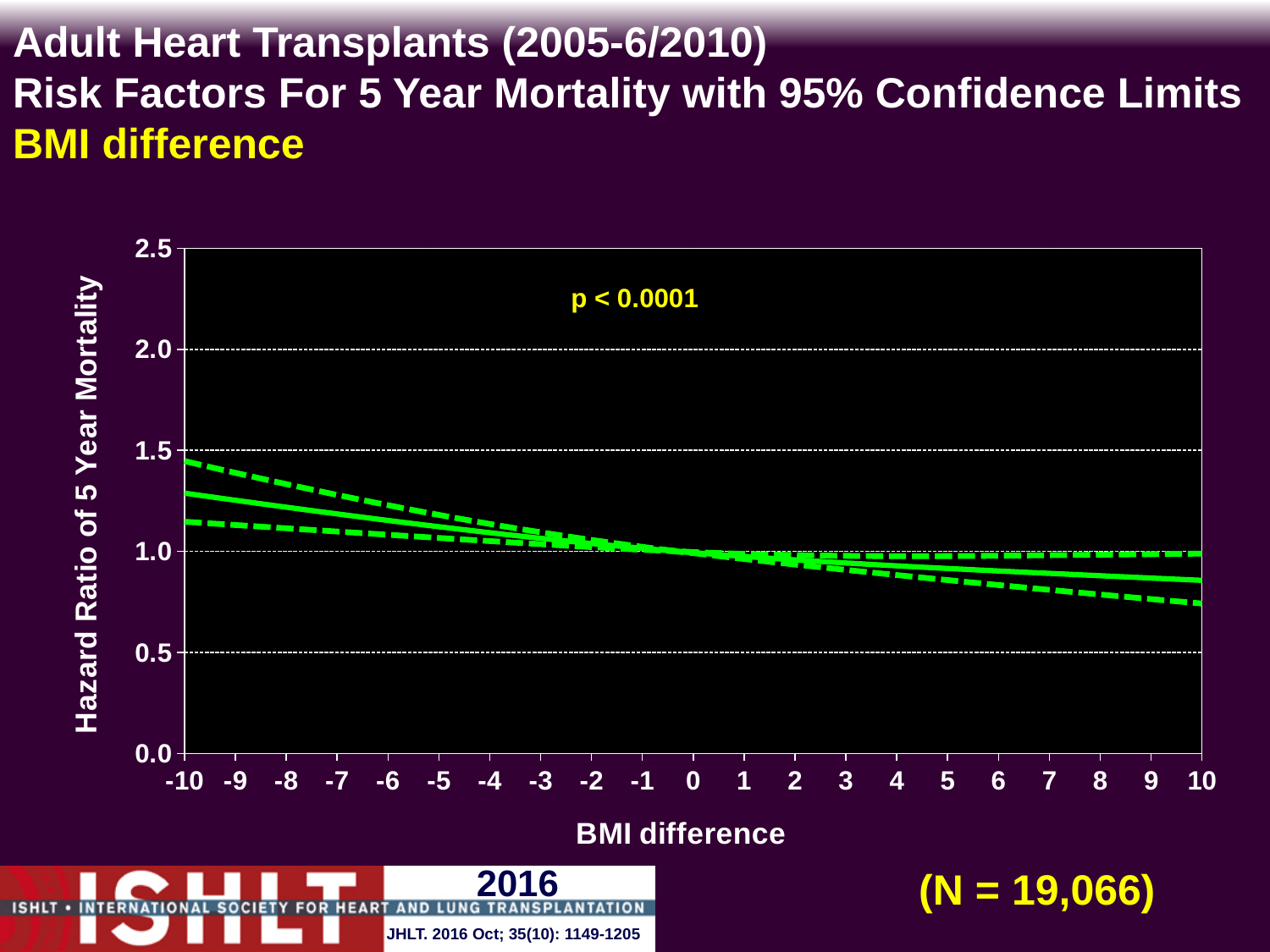
What kind of chart is shown on the slide? line chart Is the hazard ratio (solid line) at a BMI difference of 10 greater or less than 1.0? less What p-value is printed on the chart? p < 0.0001 Does the hazard ratio of 5 year mortality rise or fall as BMI difference increases from -10 to 10? fall Is the lower confidence limit at a BMI difference of 10 greater or less than 0.5? greater Which has the larger hazard ratio on the solid line: a BMI difference of -10 or a BMI difference of 10? -10 What sample size (N) is shown on the slide? N = 19,066 How many tick labels are shown on the BMI difference (x) axis? 21 How many lines are plotted on the chart (including the confidence limit lines)? 3 Is the hazard ratio (solid line) at a BMI difference of 0 greater or less than 1.5? less